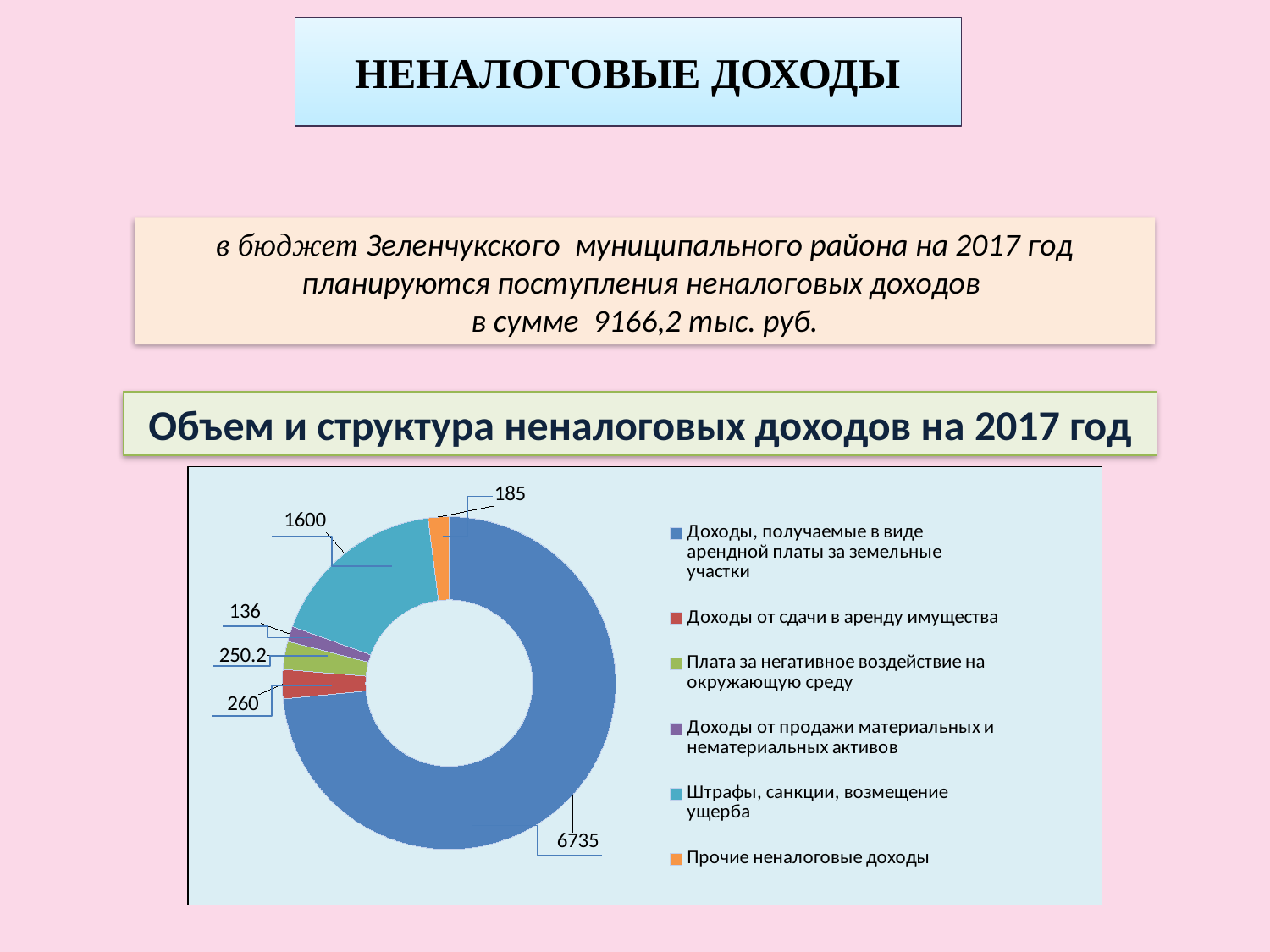
Which category has the smallest value in the chart? Доходы от продажи материальных и нематериальных активов What value is shown for 'Доходы, получаемые в виде арендной платы за земельные участки'? 6735 Which is larger: the value for 'Штрафы, санкции, возмещение ущерба' or the value for 'Доходы от сдачи в аренду имущества'? Штрафы, санкции, возмещение ущерба How many categories are shown in the chart? 6 What is the title shown above the chart? Объем и структура неналоговых доходов на 2017 год What value is shown for 'Плата за негативное воздействие на окружающую среду'? 250.2 What kind of chart is shown on the slide? Doughnut (ring) chart What is the difference between the values for 'Доходы от сдачи в аренду имущества' and 'Прочие неналоговые доходы'? 75 What value is shown for 'Прочие неналоговые доходы'? 185 Which category has the largest value in the chart? Доходы, получаемые в виде арендной платы за земельные участки What value is shown for 'Штрафы, санкции, возмещение ущерба'? 1600 What colour is the segment for 'Прочие неналоговые доходы'? Orange